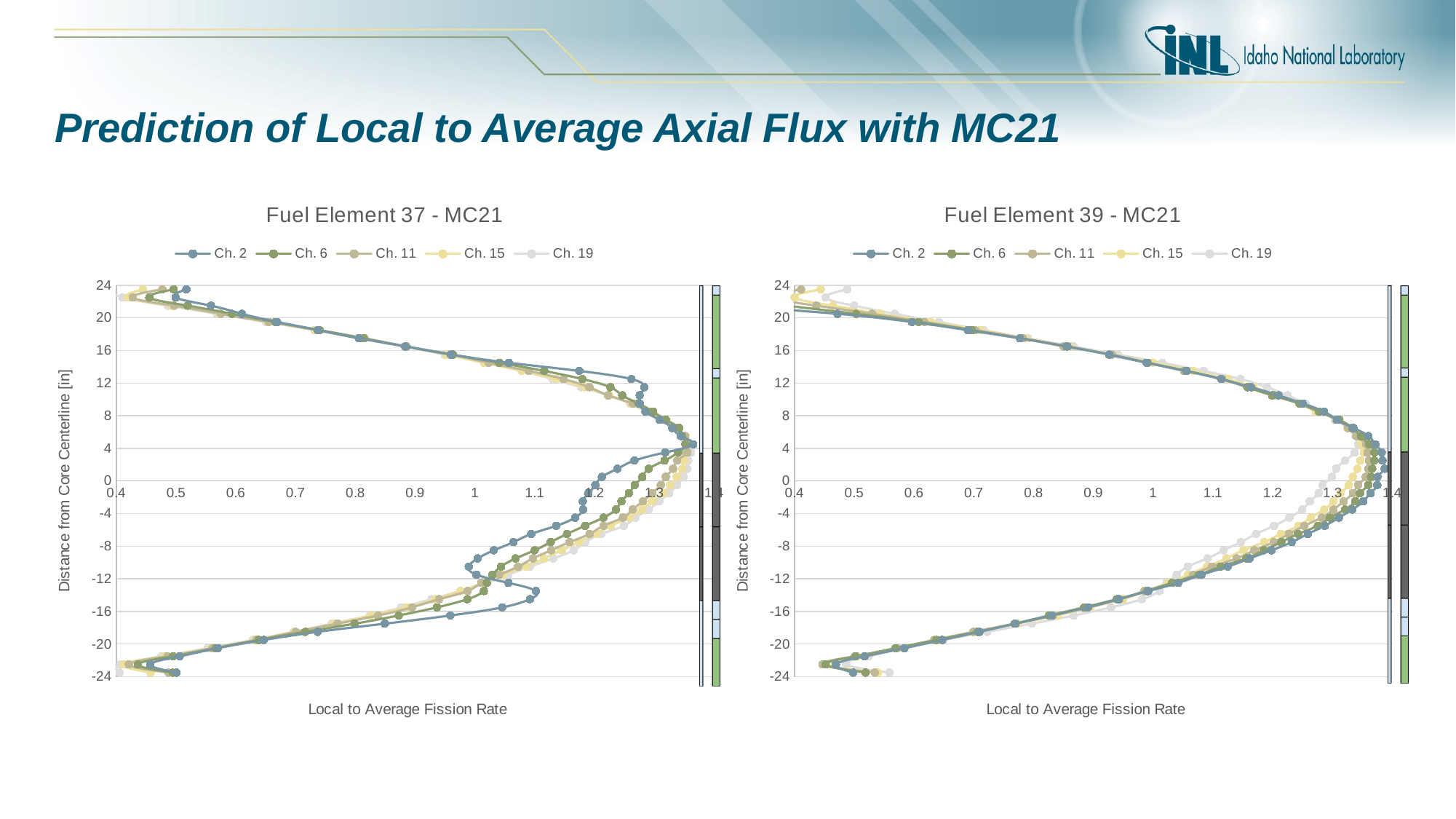
How many series does the legend of "Fuel Element 39 - MC21" list? 5 In "Fuel Element 39 - MC21", is the Ch. 19 value at 16 in from the core centerline greater or less than 1? less In "Fuel Element 39 - MC21", is the Ch. 2 value at 0 in from the core centerline greater or less than 1.3? greater In "Fuel Element 37 - MC21", is the Ch. 2 value at 20 in from the core centerline greater or less than 0.8? less What are the series names in the legend of "Fuel Element 37 - MC21"? Ch. 2, Ch. 6, Ch. 11, Ch. 15, Ch. 19 What kind of chart is "Fuel Element 37 - MC21"? Line chart In "Fuel Element 39 - MC21", does the Ch. 2 fission rate rise or fall as the distance from the core centerline goes from 24 in down to 4 in? rise What is the x-axis title of the "Fuel Element 39 - MC21" chart? Local to Average Fission Rate In "Fuel Element 37 - MC21", at -8 in from the core centerline, which is larger: the Ch. 2 value or the Ch. 19 value? Ch. 19